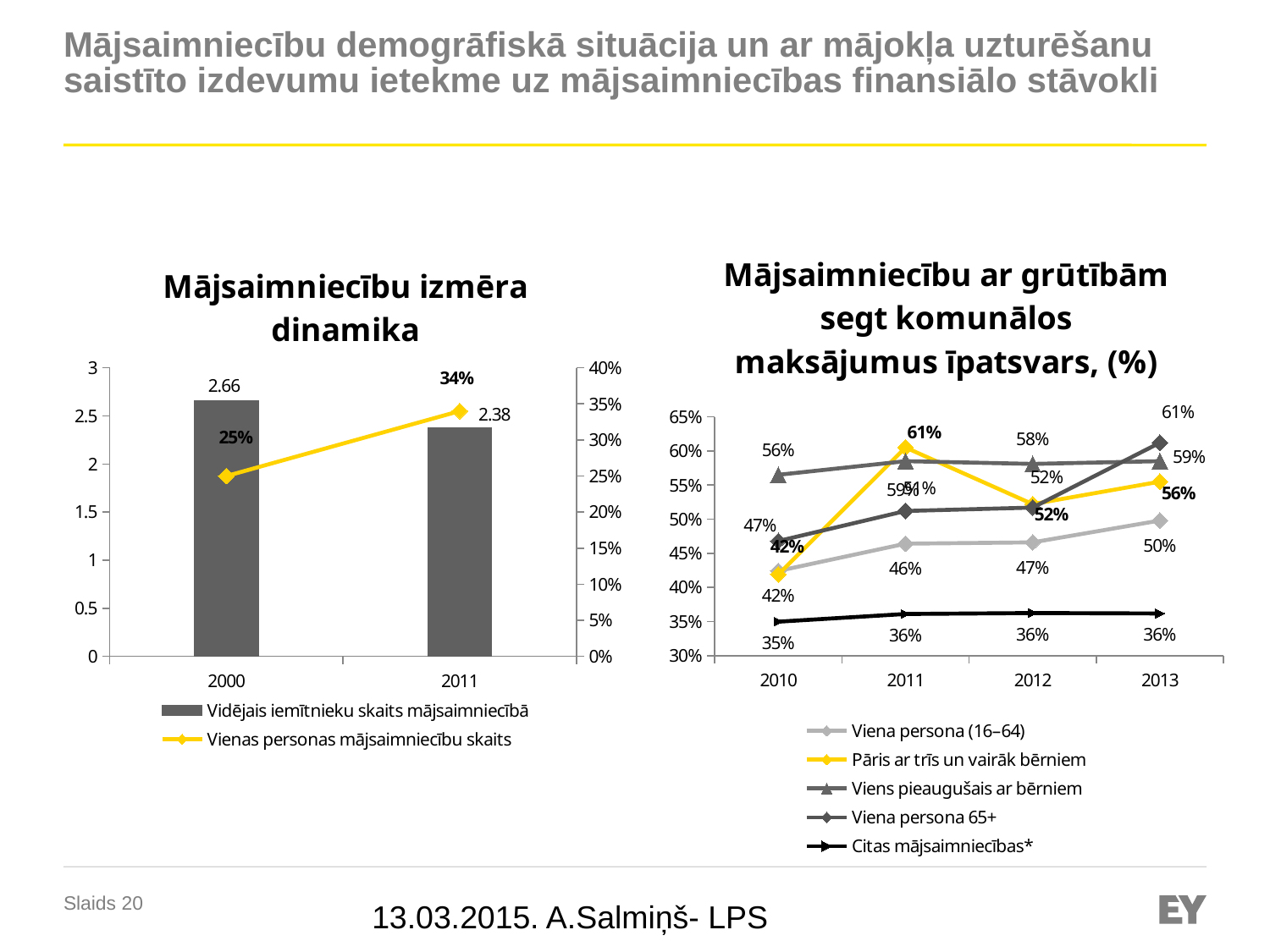
In the chart 'Mājsaimniecību izmēra dinamika', does 'Vienas personas mājsaimniecību skaits' rise or fall from 2000 to 2011? rise In the chart 'Mājsaimniecību izmēra dinamika', by how much did 'Vidējais iemītnieku skaits mājsaimniecībā' change from 2000 to 2011? 0.28 In the chart 'Mājsaimniecību izmēra dinamika', what is the value of 'Vidējais iemītnieku skaits mājsaimniecībā' for 2000? 2.66 In the right-hand chart 'Mājsaimniecību ar grūtībām segt komunālos maksājumus īpatsvars, (%)', what is the value for 'Viena persona 65+' in 2013? 61% In the right-hand chart 'Mājsaimniecību ar grūtībām segt komunālos maksājumus īpatsvars, (%)', what is the value for 'Citas mājsaimniecības*' in 2010? 35% How many series does the legend of the chart 'Mājsaimniecību izmēra dinamika' list? 2 What kind of chart is the right-hand chart 'Mājsaimniecību ar grūtībām segt komunālos maksājumus īpatsvars, (%)'? line chart In the right-hand chart 'Mājsaimniecību ar grūtībām segt komunālos maksājumus īpatsvars, (%)', which series has the lowest value in 2013? Citas mājsaimniecības* In the right-hand chart 'Mājsaimniecību ar grūtībām segt komunālos maksājumus īpatsvars, (%)', what is the value for 'Pāris ar trīs un vairāk bērniem' in 2011? 61% How many series does the legend of the right-hand chart 'Mājsaimniecību ar grūtībām segt komunālos maksājumus īpatsvars, (%)' list? 5 In the right-hand chart 'Mājsaimniecību ar grūtībām segt komunālos maksājumus īpatsvars, (%)', what is the difference between 'Viena persona (16–64)' in 2013 and in 2010? 8% In the chart 'Mājsaimniecību izmēra dinamika', what is the value of 'Vienas personas mājsaimniecību skaits' for 2011? 34%